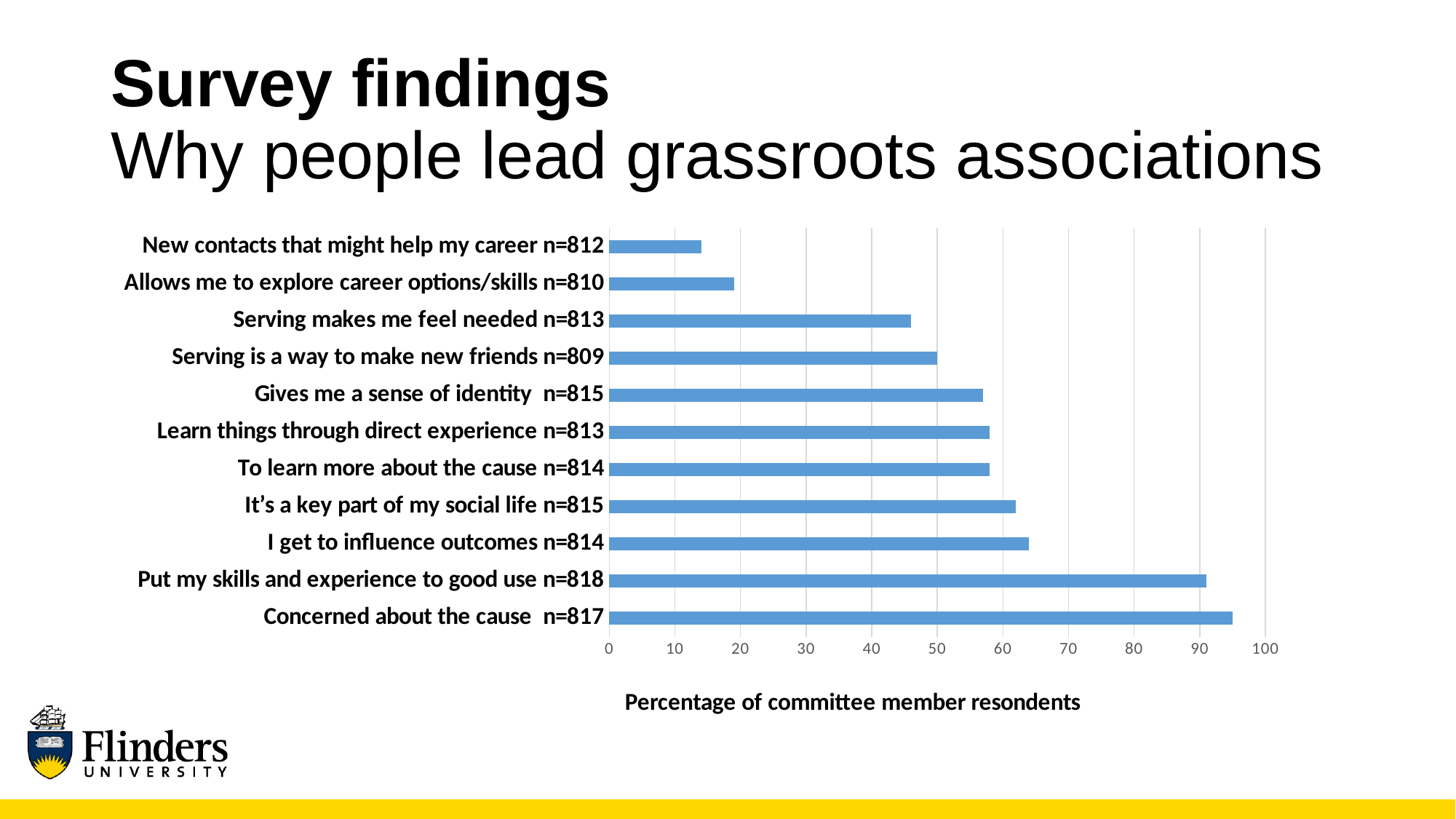
Is the value for 'Serving makes me feel needed' greater or less than 50? less Is the value for 'Gives me a sense of identity' greater or less than 60? less Is the value for 'New contacts that might help my career' greater or less than 20? less How many reasons (categories) are plotted in the chart? 11 What is the title of the horizontal axis of the chart? Percentage of committee member resondents Which reason has the lowest percentage of committee member respondents? New contacts that might help my career Which is larger: the value for 'Put my skills and experience to good use' or the value for 'It's a key part of my social life'? Put my skills and experience to good use Which reason has the highest percentage of committee member respondents? Concerned about the cause Which is larger: the value for 'I get to influence outcomes' or the value for 'Gives me a sense of identity'? I get to influence outcomes What kind of chart is shown on the slide? bar chart